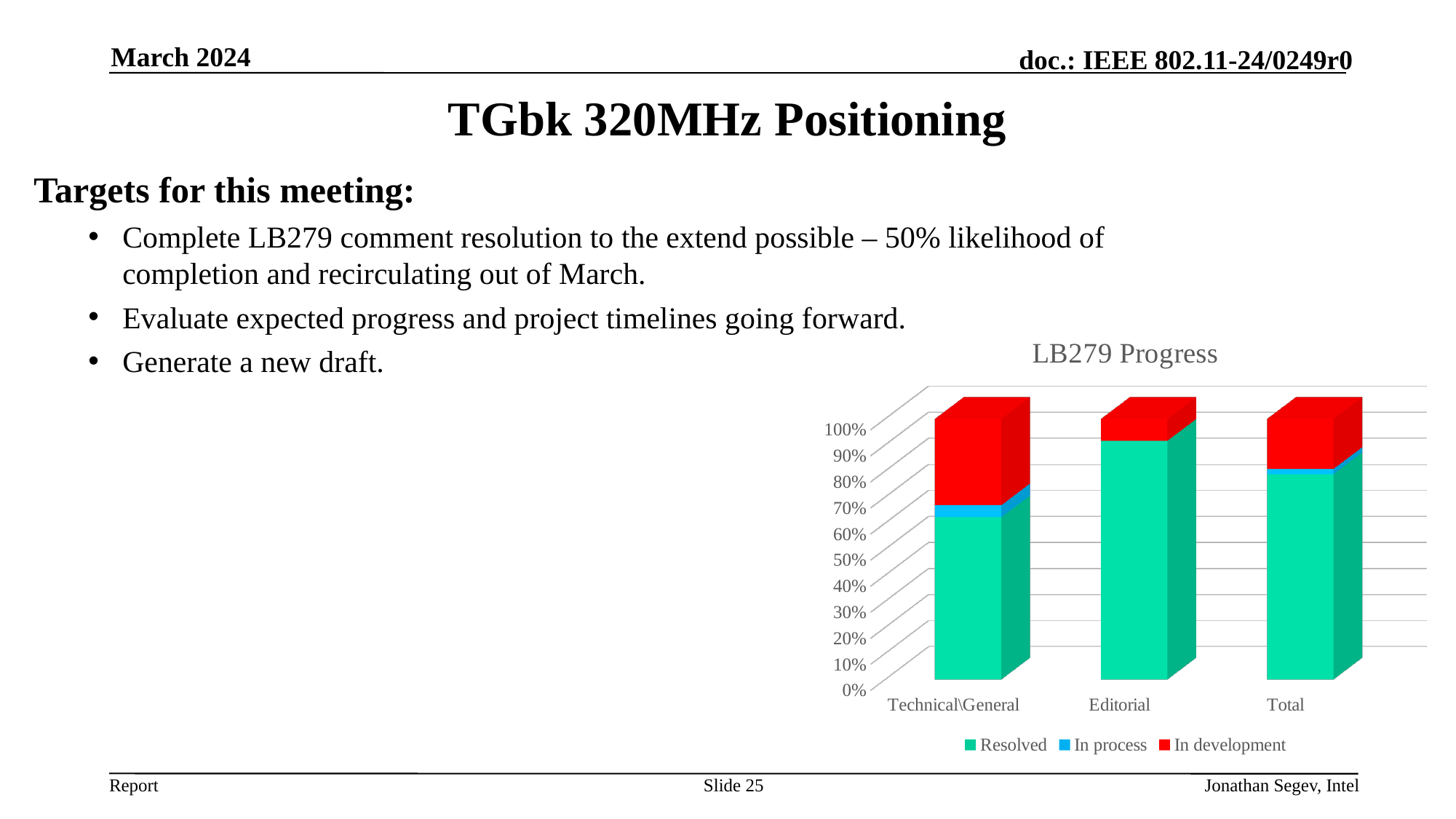
Is the Resolved share for Technical\General greater or less than 50%? greater Is the In development share for Technical\General greater or less than 20%? greater Is the Resolved share for Editorial greater or less than 80%? greater What kind of chart is shown on the slide? Stacked bar chart What is the title of the chart? LB279 Progress How many series does the chart legend list? 3 Which category has the largest In development share? Technical\General How many categories are shown on the x axis of the chart? 3 Which is larger, the Resolved share for Total or the Resolved share for Technical\General? Total Which series is shown in red in the chart? In development Which category has the highest Resolved share? Editorial Which category has the lowest Resolved share? Technical\General